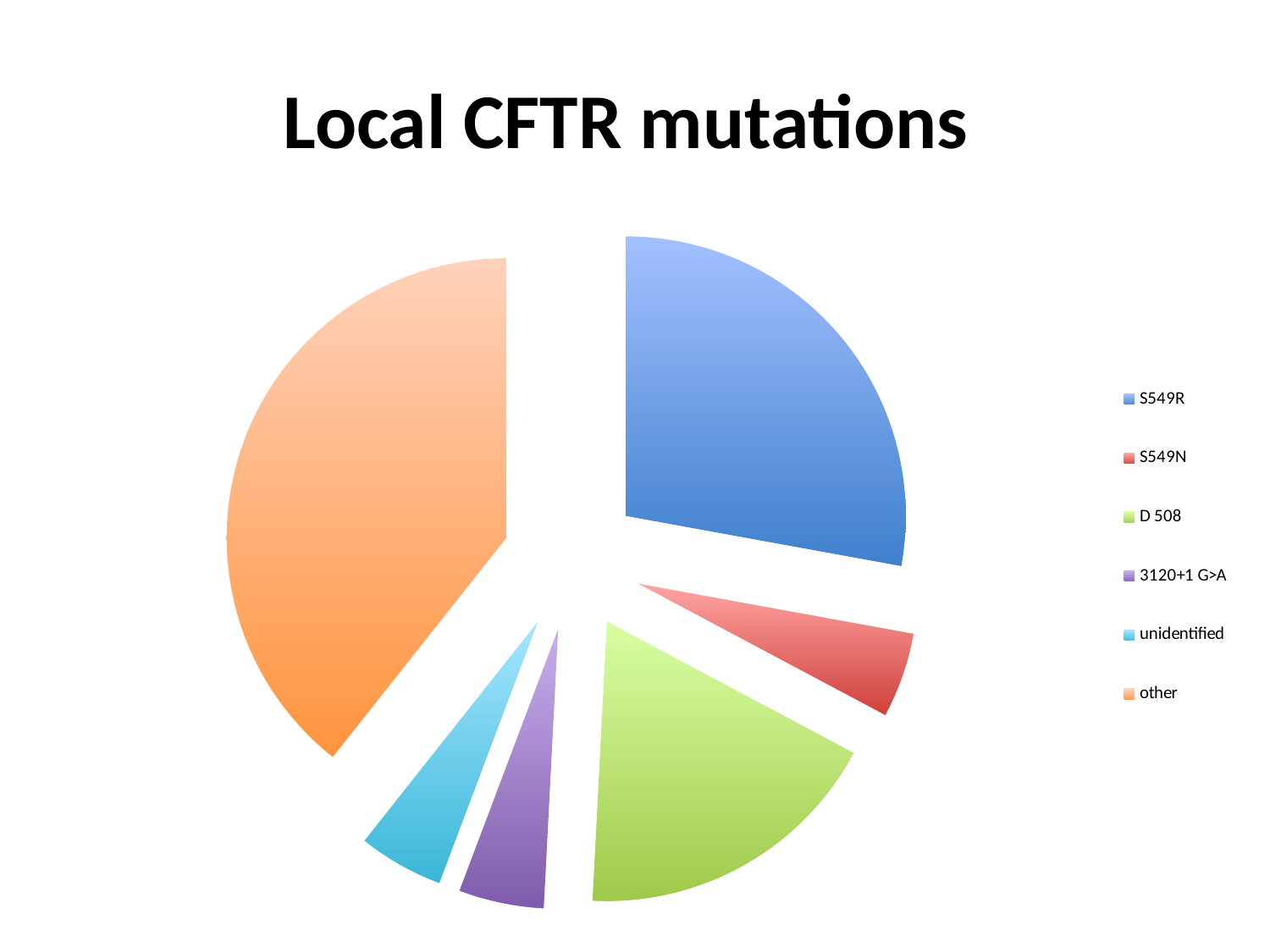
How many slices does the pie chart have? 6 What kind of chart is shown on the slide? pie chart How many categories does the legend list? 6 Which category has the largest slice of the pie? other Which slice is larger, S549R or S549N? S549R What is the title of the chart? Local CFTR mutations Which slice is larger, S549R or unidentified? S549R Which slice is larger, S549R or D 508? S549R What colour is the slice for D 508? green